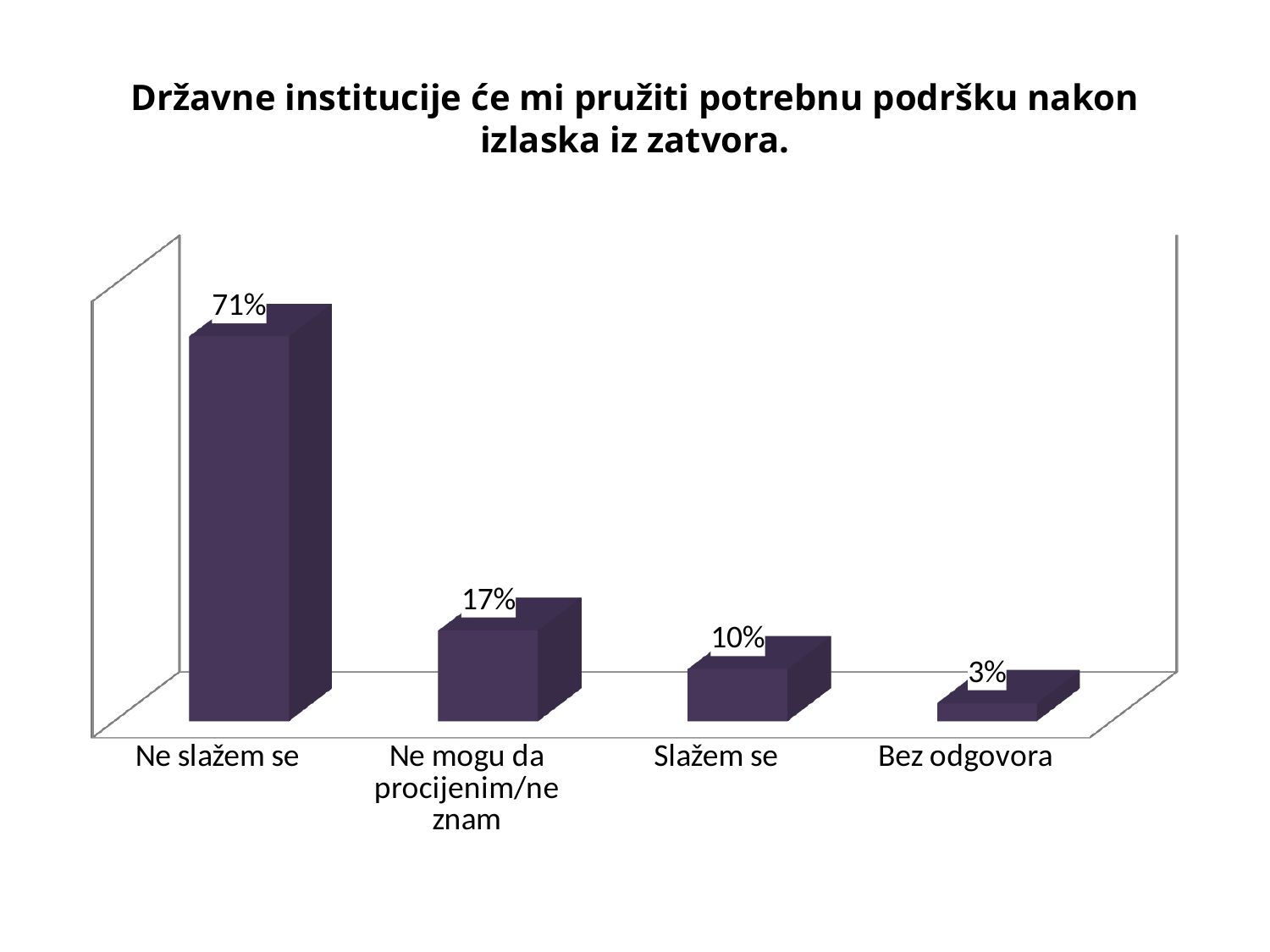
What kind of chart is shown on the slide? Bar chart What is the value for "Ne slažem se"? 71% Which category has the highest value? Ne slažem se What is the value for "Ne mogu da procijenim/ne znam"? 17% Which is larger, the value for "Ne mogu da procijenim/ne znam" or the value for "Slažem se"? Ne mogu da procijenim/ne znam What is the value for "Bez odgovora"? 3% Which category has the lowest value? Bez odgovora How many categories are shown on the chart? 4 What is the difference between the values for "Ne slažem se" and "Slažem se"? 61% What is the value for "Slažem se"? 10% What is the title of the chart? Državne institucije će mi pružiti potrebnu podršku nakon izlaska iz zatvora. What is the difference between the values for "Ne mogu da procijenim/ne znam" and "Bez odgovora"? 14%